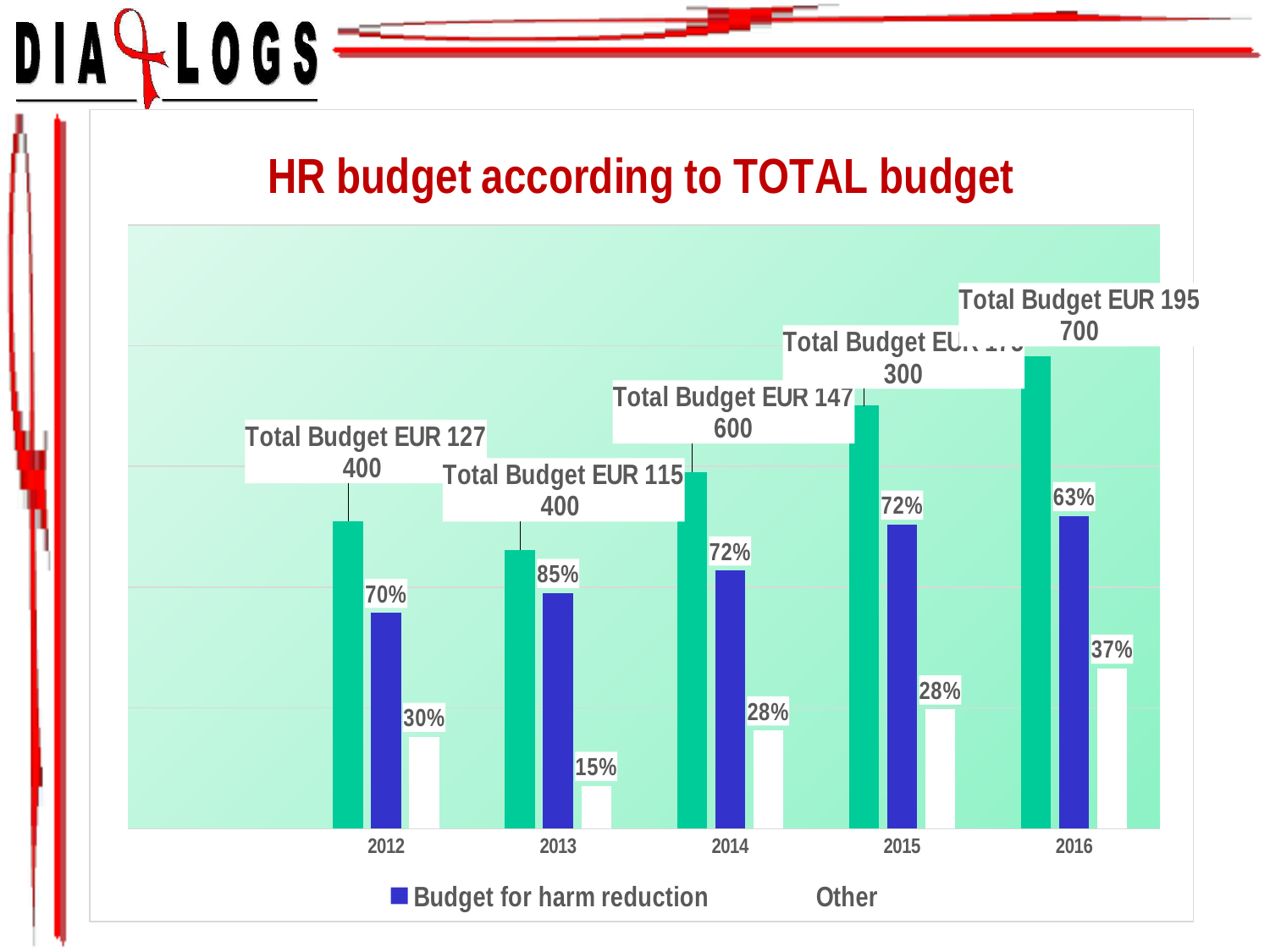
What percentage is shown for Other in 2016? 37% Which year has the larger Budget for harm reduction percentage, 2012 or 2016? 2012 How many series does the legend list? 2 How many years are shown on the x axis? 5 In which year is the Other percentage lowest? 2013 In which year is the total budget bar the tallest? 2016 In which year is the Budget for harm reduction percentage highest? 2013 What percentage is shown for Budget for harm reduction in 2013? 85% What kind of chart is shown on the slide? Bar chart What is the total budget labelled for 2016? Total Budget EUR 195 700 What is the difference between the Budget for harm reduction and Other percentages in 2016? 26 percentage points What is the total budget labelled for 2012? Total Budget EUR 127 400